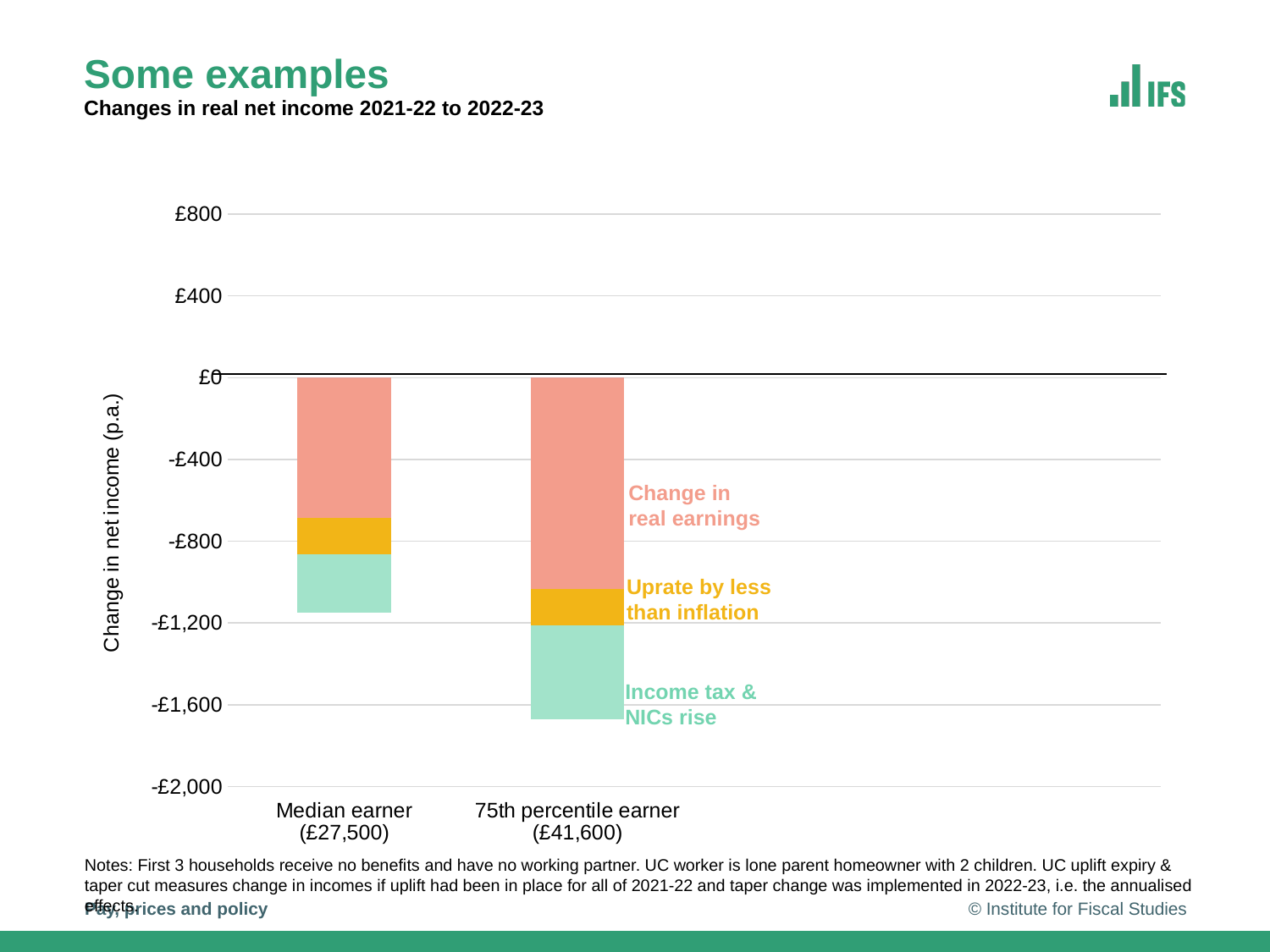
How many components (series) make up each stacked bar? 3 Is the total change in net income for the 75th percentile earner greater or less than -£1,600? less What is the label on the y axis? Change in net income (p.a.) What income is shown in brackets for the 75th percentile earner? £41,600 Is the total change in net income for the median earner greater or less than -£1,200? greater Which component is the smallest part of the 75th percentile earner's bar? Uprate by less than inflation Is the total change in net income for the median earner greater or less than -£800? less Which earner has the larger overall fall in net income, the median earner or the 75th percentile earner? 75th percentile earner What kind of chart is shown on the slide? Stacked bar chart How many earner categories are plotted on the x axis? 2 Which component is the largest part of the 75th percentile earner's bar? Change in real earnings